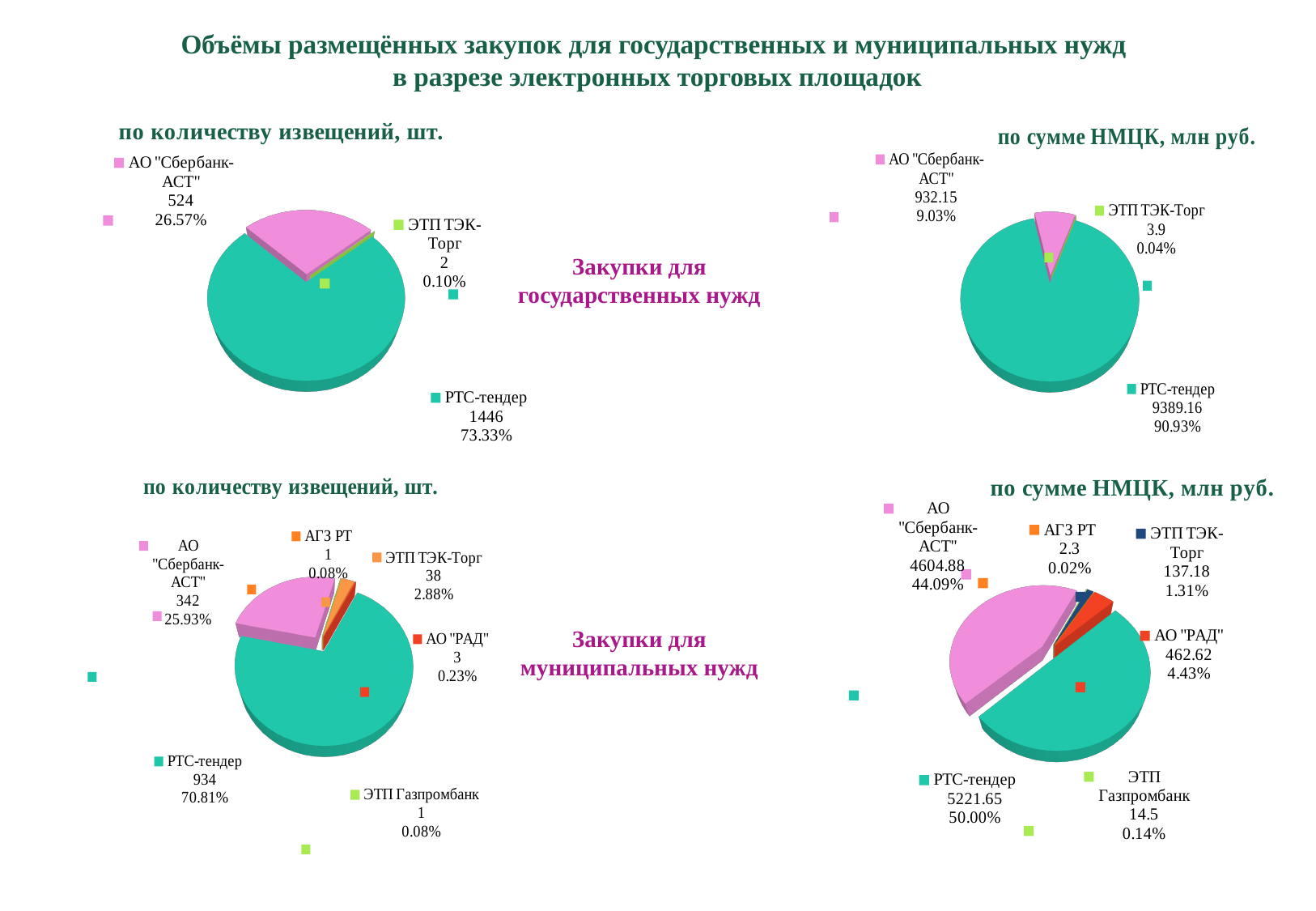
In the top-left pie chart (по количеству извещений, шт., state needs), what is the value for РТС-тендер? 1446 In the bottom-left pie chart (по количеству извещений, шт., municipal needs), what is the difference between РТС-тендер and АО "Сбербанк-АСТ"? 592 In the top-left pie chart (по количеству извещений, шт., state needs), what share does АО "Сбербанк-АСТ" have? 26.57% In the top-right pie chart (по сумме НМЦК, млн руб., state needs), what share does РТС-тендер have? 90.93% In the bottom-right pie chart (по сумме НМЦК, млн руб., municipal needs), what is the value for АО "РАД"? 462.62 In the bottom-left pie chart (по количеству извещений, шт., municipal needs), what is the value for ЭТП ТЭК-Торг? 38 In the top-right pie chart (по сумме НМЦК, млн руб., state needs), how many categories are shown? 3 In the bottom-right pie chart (по сумме НМЦК, млн руб., municipal needs), which category has the largest value? РТС-тендер In the top-right pie chart (по сумме НМЦК, млн руб., state needs), what is the value for АО "Сбербанк-АСТ"? 932.15 In the top-left pie chart (по количеству извещений, шт., state needs), which category has the smallest value? ЭТП ТЭК-Торг In the bottom-left pie chart (по количеству извещений, шт., municipal needs), how many categories are shown? 6 What type of chart is used on this slide? Pie chart